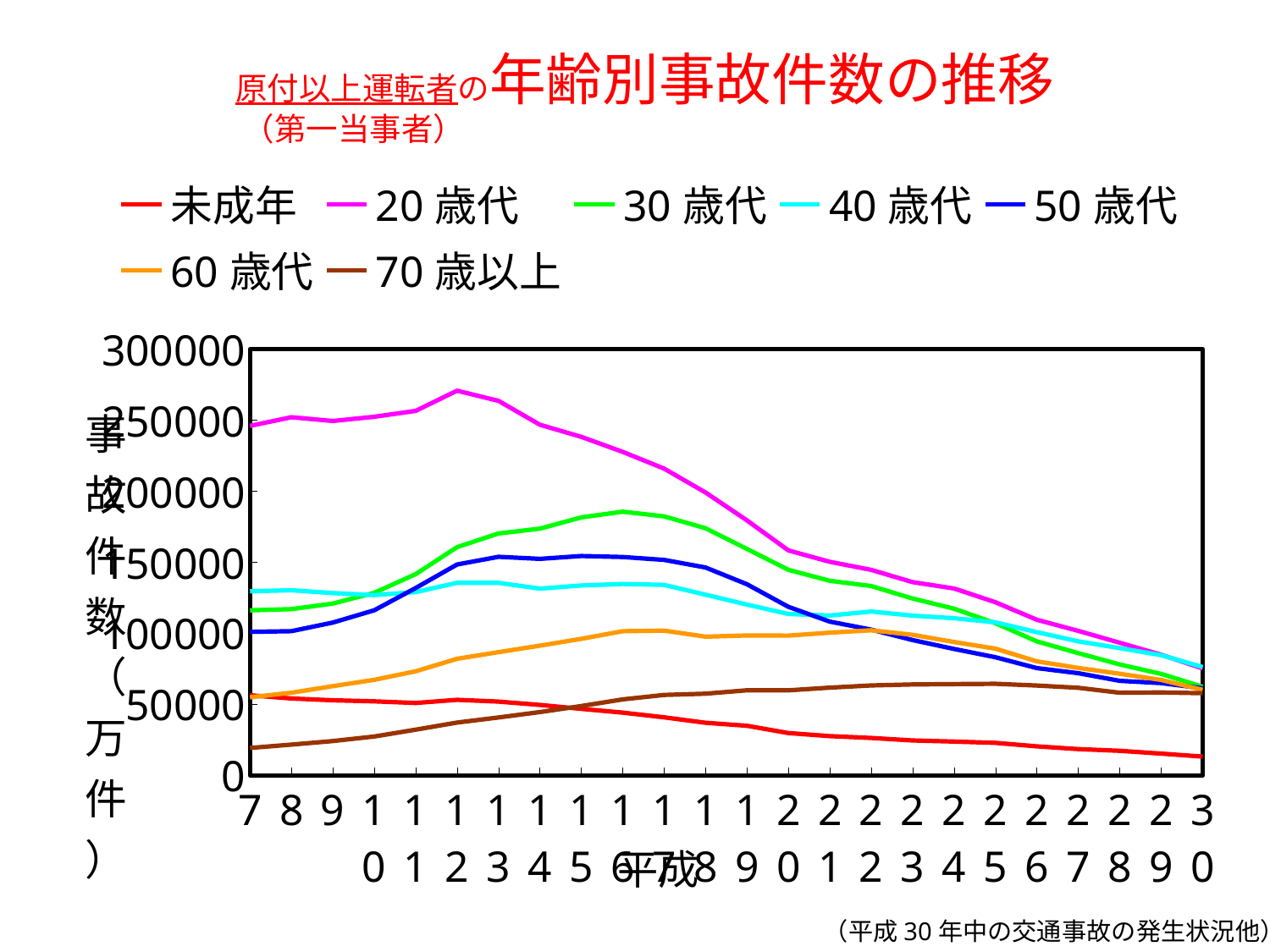
What kind of chart is shown on the slide? line chart Which series has the highest value in 平成12? 20歳代 In 平成7, which is larger: the value for 20歳代 or the value for 30歳代? 20歳代 In 平成30, which is larger: the value for 未成年 or the value for 70歳以上? 70歳以上 Which series has the lowest value in 平成30? 未成年 Is the value for 30歳代 in 平成16 greater or less than 150000? greater How many series does the legend list? 7 Is the value for 20歳代 in 平成12 greater or less than 250000? greater Is the value for 70歳以上 in 平成7 greater or less than 50000? less How many years (points) are shown along the x axis? 24 Does the value for 未成年 rise or fall from 平成7 to 平成30? fall